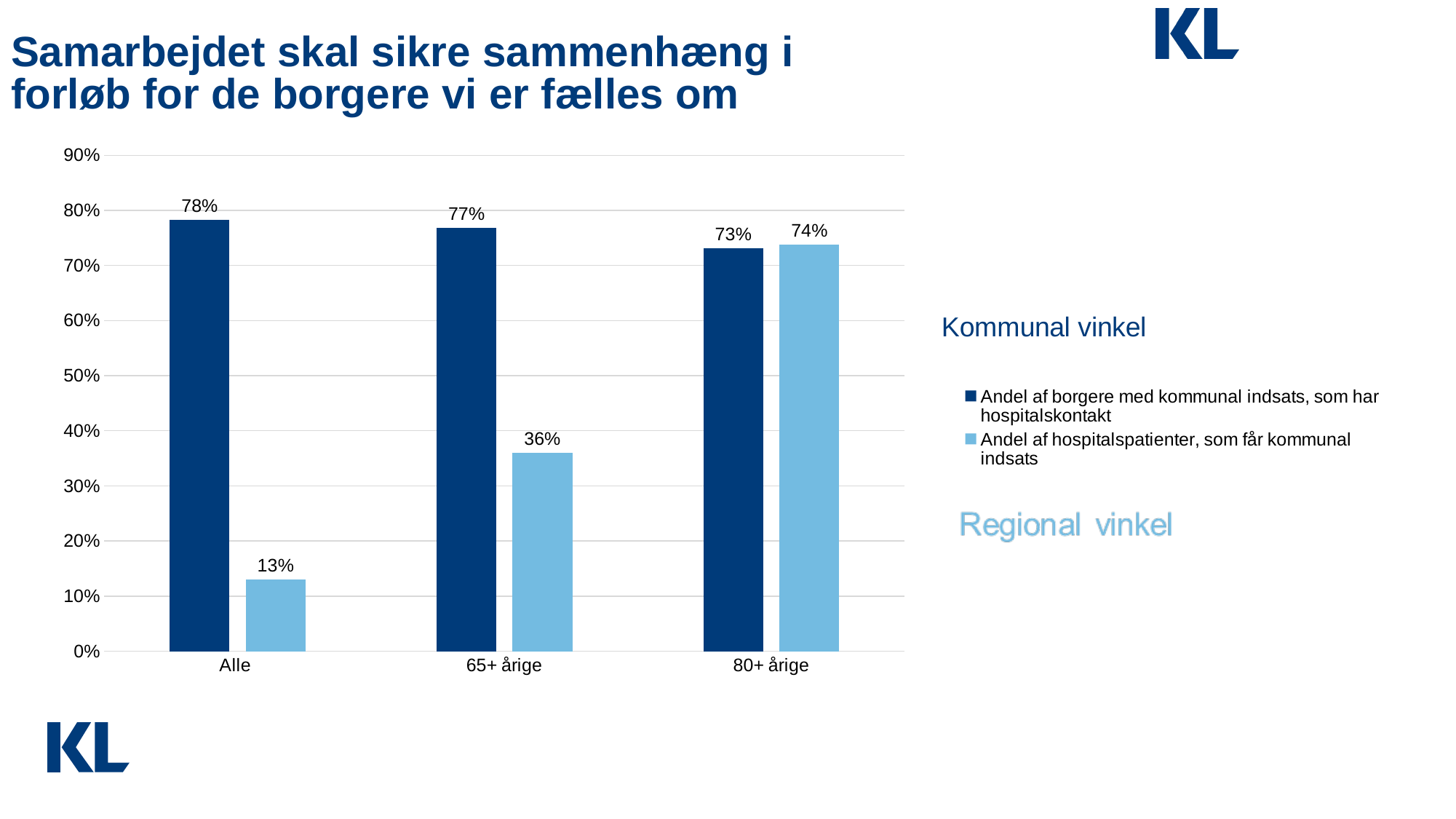
Which category has the lowest value for 'Andel af hospitalspatienter, som får kommunal indsats'? Alle Which category has the highest value for 'Andel af borgere med kommunal indsats, som har hospitalskontakt'? Alle What kind of chart is shown on the slide? Bar chart What is the value for 'Andel af hospitalspatienter, som får kommunal indsats' for 80+ årige? 74% How many categories are shown on the x axis? 3 What is the value for 'Andel af borgere med kommunal indsats, som har hospitalskontakt' for Alle? 78% What is the difference between the 'Andel af hospitalspatienter, som får kommunal indsats' values for 80+ årige and 65+ årige? 38% What is the value for 'Andel af hospitalspatienter, som får kommunal indsats' for 65+ årige? 36% What is the difference between the two series for Alle? 65% Do the values for 'Andel af hospitalspatienter, som får kommunal indsats' rise or fall from Alle to 80+ årige? Rise For 65+ årige, which series has the larger value? Andel af borgere med kommunal indsats, som har hospitalskontakt How many series does the legend list? 2